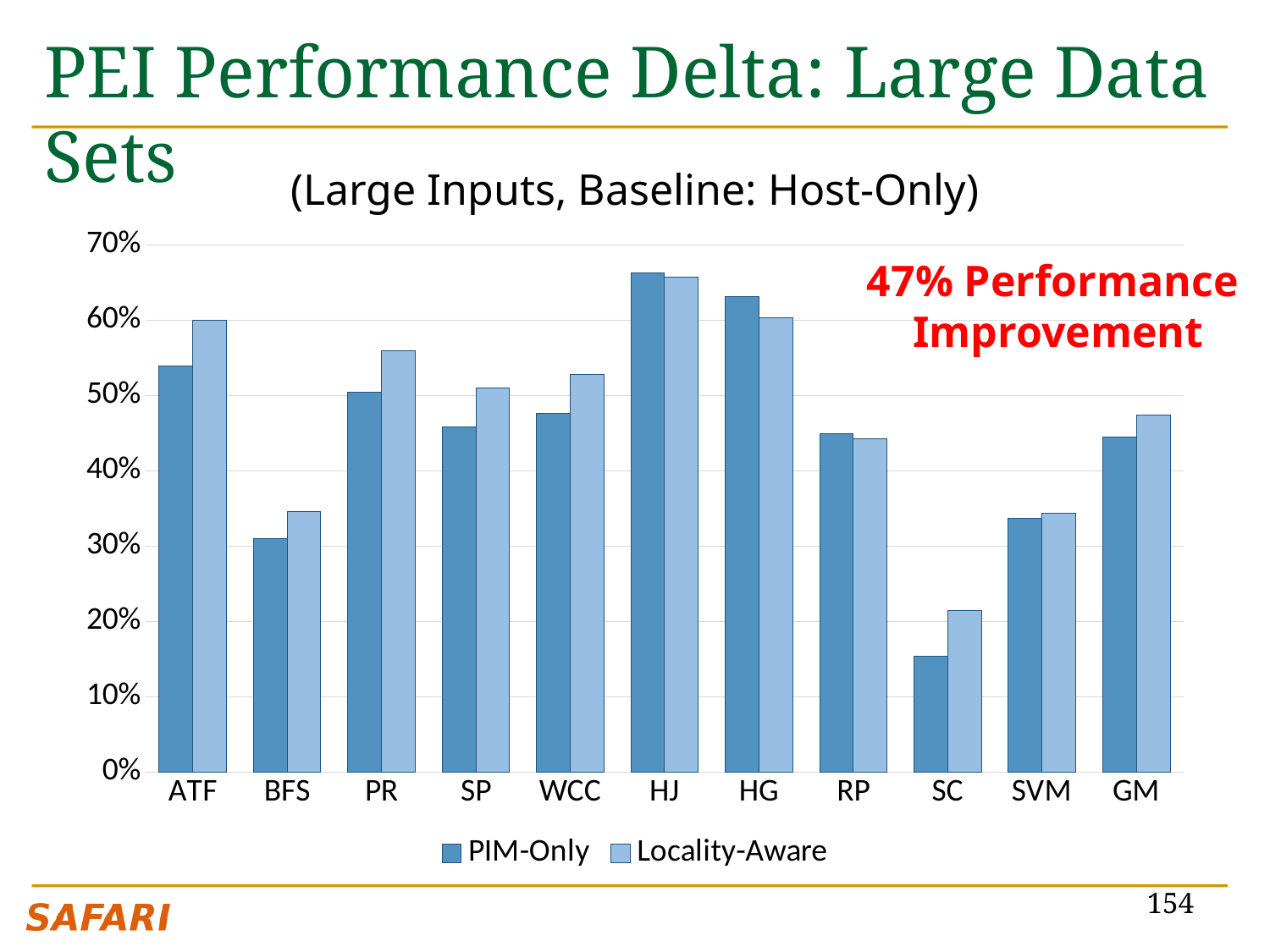
Which category has the lowest PIM-Only value? SC Is the Locality-Aware value for GM greater or less than 50%? less How many series does the legend list? 2 Which category has the highest PIM-Only value? HJ What are the two legend entries of the chart? PIM-Only and Locality-Aware How many categories are shown on the x axis? 11 Is the PIM-Only value for SC greater or less than 20%? less For PR, which is larger: the PIM-Only value or the Locality-Aware value? Locality-Aware What kind of chart is shown on the slide? bar chart Is the PIM-Only value for ATF greater or less than 50%? greater Which category has the lowest Locality-Aware value? SC For HG, which is larger: the PIM-Only value or the Locality-Aware value? PIM-Only